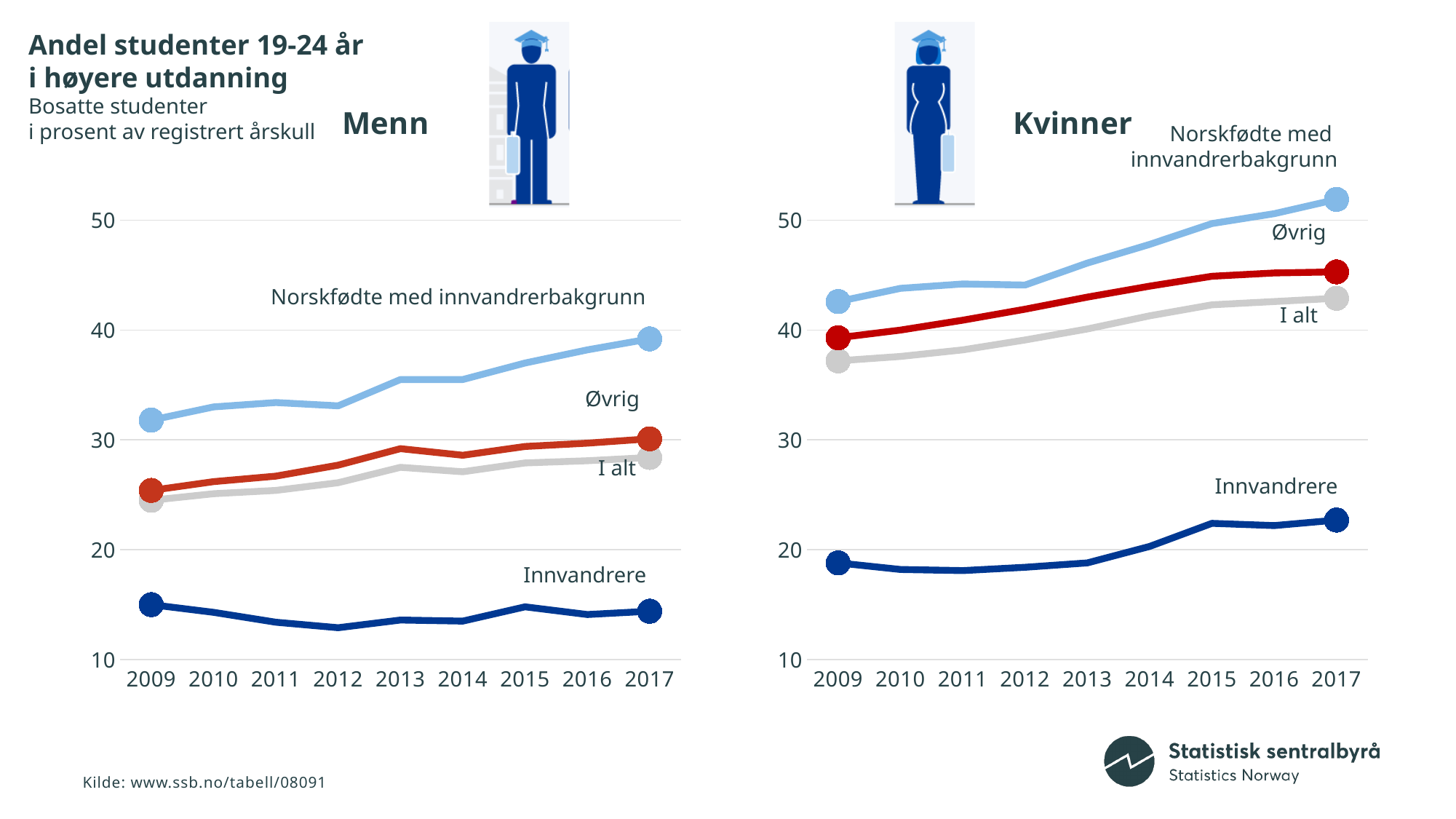
In the Menn chart, does the Norskfødte med innvandrerbakgrunn line rise or fall from 2009 to 2017? rise In the Kvinner chart, is the value for I alt in 2009 greater or less than 40? less In the Menn chart, which series has the highest value in 2017? Norskfødte med innvandrerbakgrunn In the Menn chart, is the value for Innvandrere in 2017 greater or less than 20? less How many series are plotted in the Menn chart? 4 In the Menn chart, is the value for Norskfødte med innvandrerbakgrunn in 2017 greater or less than 40? less In the Kvinner chart, which is larger in 2017: Øvrig or I alt? Øvrig In the Kvinner chart, which series has the lowest value in 2017? Innvandrere How many years are plotted on the x axis of the Kvinner chart? 9 What kind of chart is the Menn chart? line chart